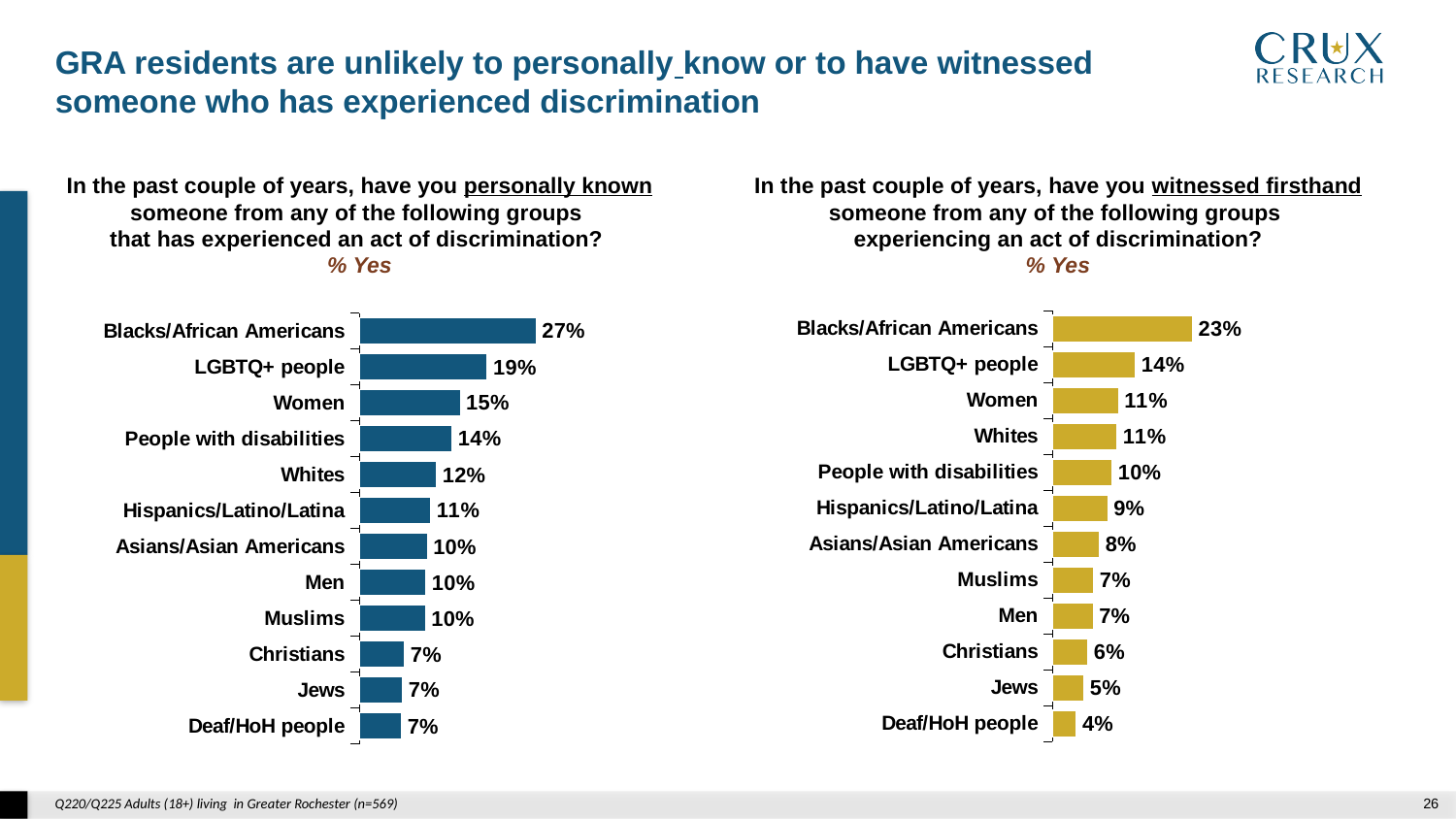
In the right chart (witnessed firsthand), which group has the highest percentage? Blacks/African Americans What colour are the bars in the right chart (witnessed firsthand)? Gold/yellow In the right chart (witnessed firsthand), what percentage is shown for LGBTQ+ people? 14% Which is larger: the percentage for Whites in the left chart (personally known) or the percentage for Whites in the right chart (witnessed firsthand)? Left chart (personally known), 12% In the left chart (personally known), what is the difference between the percentages for Blacks/African Americans and LGBTQ+ people? 8 percentage points In the right chart (witnessed firsthand), which group has the lowest percentage? Deaf/HoH people In the left chart (personally known), which group has the lowest percentage? Christians, Jews, and Deaf/HoH people (all 7%) In the right chart (witnessed firsthand), what is the difference between the percentages for Women and Jews? 6 percentage points In the left chart (personally known), what percentage is shown for People with disabilities? 14% What type of chart is used on the right side of the slide (witnessed firsthand)? Bar chart How many groups are listed in the left chart (personally known)? 12 In the left chart (personally known), what percentage is shown for Blacks/African Americans? 27%